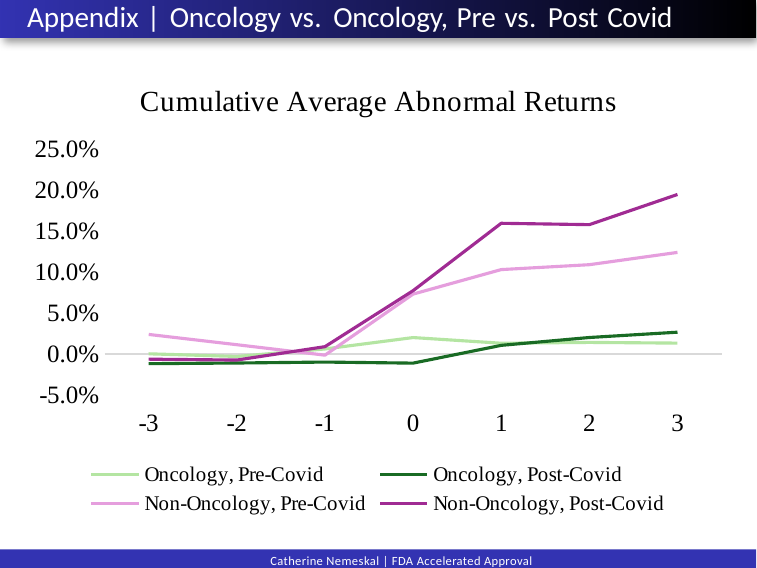
Is the value for Non-Oncology, Post-Covid at x = 3 greater or less than 15.0%? greater Which series has the highest value at x = 3? Non-Oncology, Post-Covid How many series does the legend list? 4 What kind of chart is shown on the slide? line chart Is the value for Non-Oncology, Pre-Covid at x = 3 greater or less than 10.0%? greater How many points are plotted along the x axis for each series? 7 At x = -3, which is larger: Non-Oncology, Pre-Covid or Oncology, Post-Covid? Non-Oncology, Pre-Covid At x = 3, which is larger: Non-Oncology, Post-Covid or Non-Oncology, Pre-Covid? Non-Oncology, Post-Covid What is the title of the chart? Cumulative Average Abnormal Returns Does the Non-Oncology, Post-Covid series rise or fall from x = -1 to x = 3? rise Is the value for Oncology, Post-Covid at x = 3 greater or less than 5.0%? less